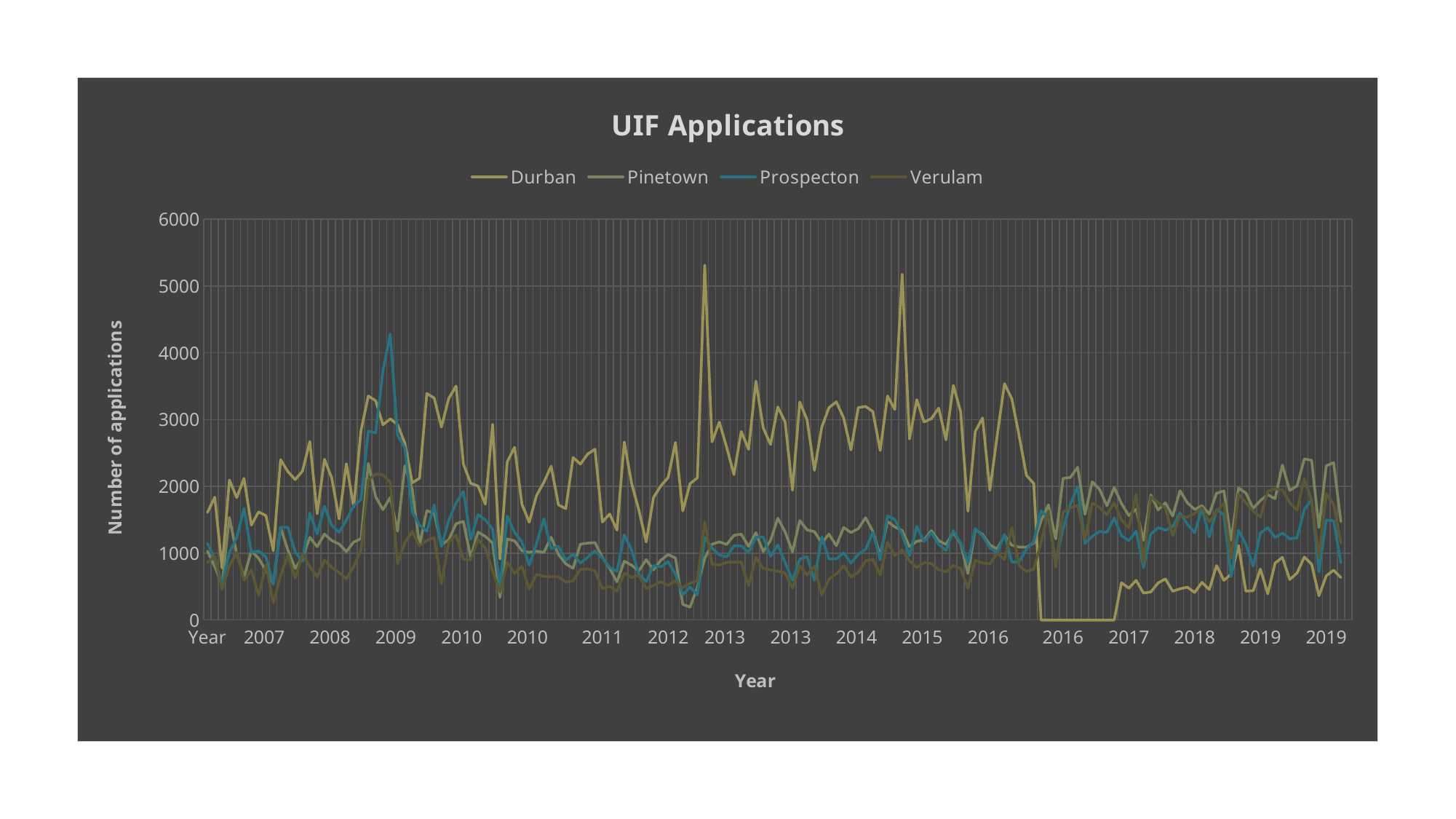
Is the highest value of the Verulam line greater or less than 3000? less Which series reaches the highest value on the chart? Durban Is the highest value of the Durban line greater or less than 5000? greater Which series drops to 0 on the chart? Durban What kind of chart is shown on the slide? Line chart What is the title of the chart? UIF Applications Does the Durban line generally rise or fall from 2015 to 2019? fall How many series does the legend list? 4 Is the highest value of the Prospecton line greater or less than 4000? greater What is the label on the vertical axis? Number of applications Around 2018, which series is higher, Durban or Pinetown? Pinetown